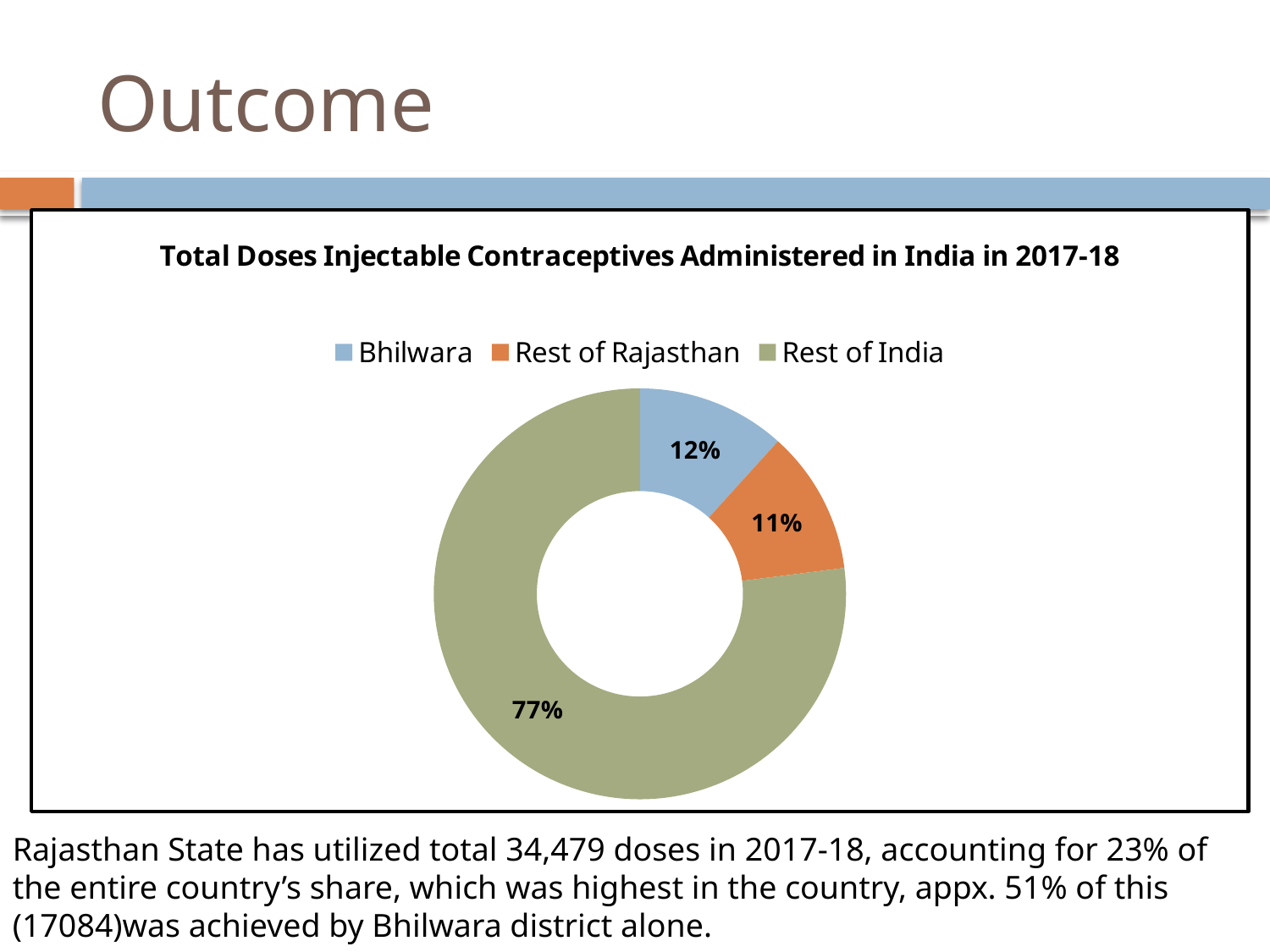
What is the combined share of Bhilwara and Rest of Rajasthan? 23% Which category has the largest share in the chart? Rest of India How many categories are shown in the chart? 3 What is the title of the chart? Total Doses Injectable Contraceptives Administered in India in 2017-18 Which colour represents Rest of Rajasthan in the chart? Orange What share of the doughnut chart does Bhilwara account for? 12% What is the difference in percentage points between the Rest of India share and the Bhilwara share? 65 What share of the doughnut chart does Rest of India account for? 77% Which has a larger share, Bhilwara or Rest of Rajasthan? Bhilwara Which category has the smallest share in the chart? Rest of Rajasthan What share of the doughnut chart does Rest of Rajasthan account for? 11% What kind of chart is shown on the slide? Doughnut (pie) chart